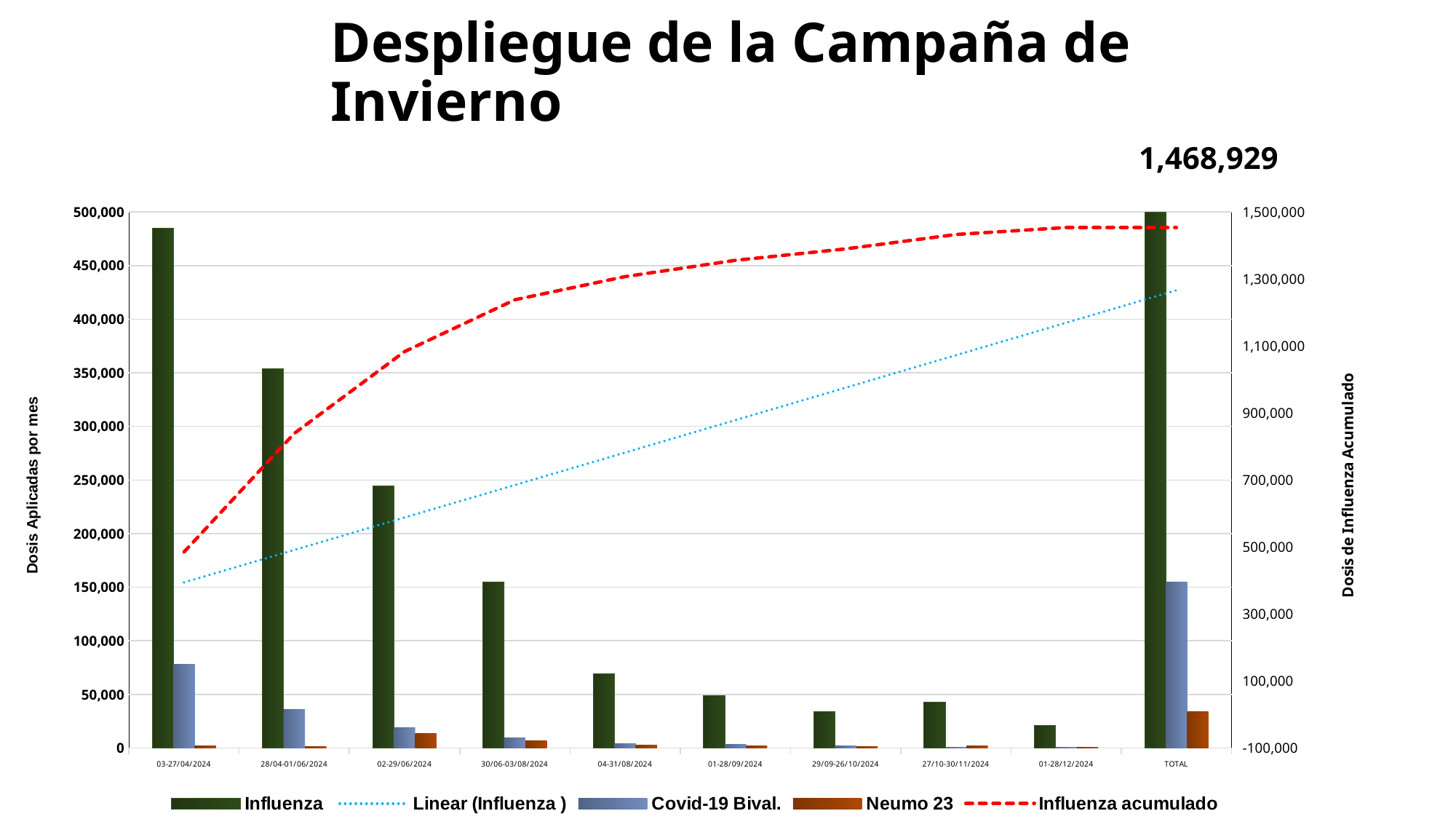
Is the Influenza value for 28/04-01/06/2024 greater or less than 300,000? greater What number is printed above the chart at the top right? 1,468,929 Which is larger, the Influenza value for 04-31/08/2024 or for 01-28/09/2024? 04-31/08/2024 Is the Influenza value for 03-27/04/2024 greater or less than 450,000? greater How many categories are shown along the x axis, including TOTAL? 10 Which period has the highest Influenza bar among the monthly periods (excluding TOTAL)? 03-27/04/2024 How many series does the chart legend list? 5 Which period has the lowest Influenza bar? 01-28/12/2024 Is the Covid-19 Bival. value for 03-27/04/2024 greater or less than 50,000? greater Do the Influenza bars rise or fall across the monthly periods from 03-27/04/2024 to 01-28/12/2024? fall What is the title of the chart on the slide? Despliegue de la Campaña de Invierno